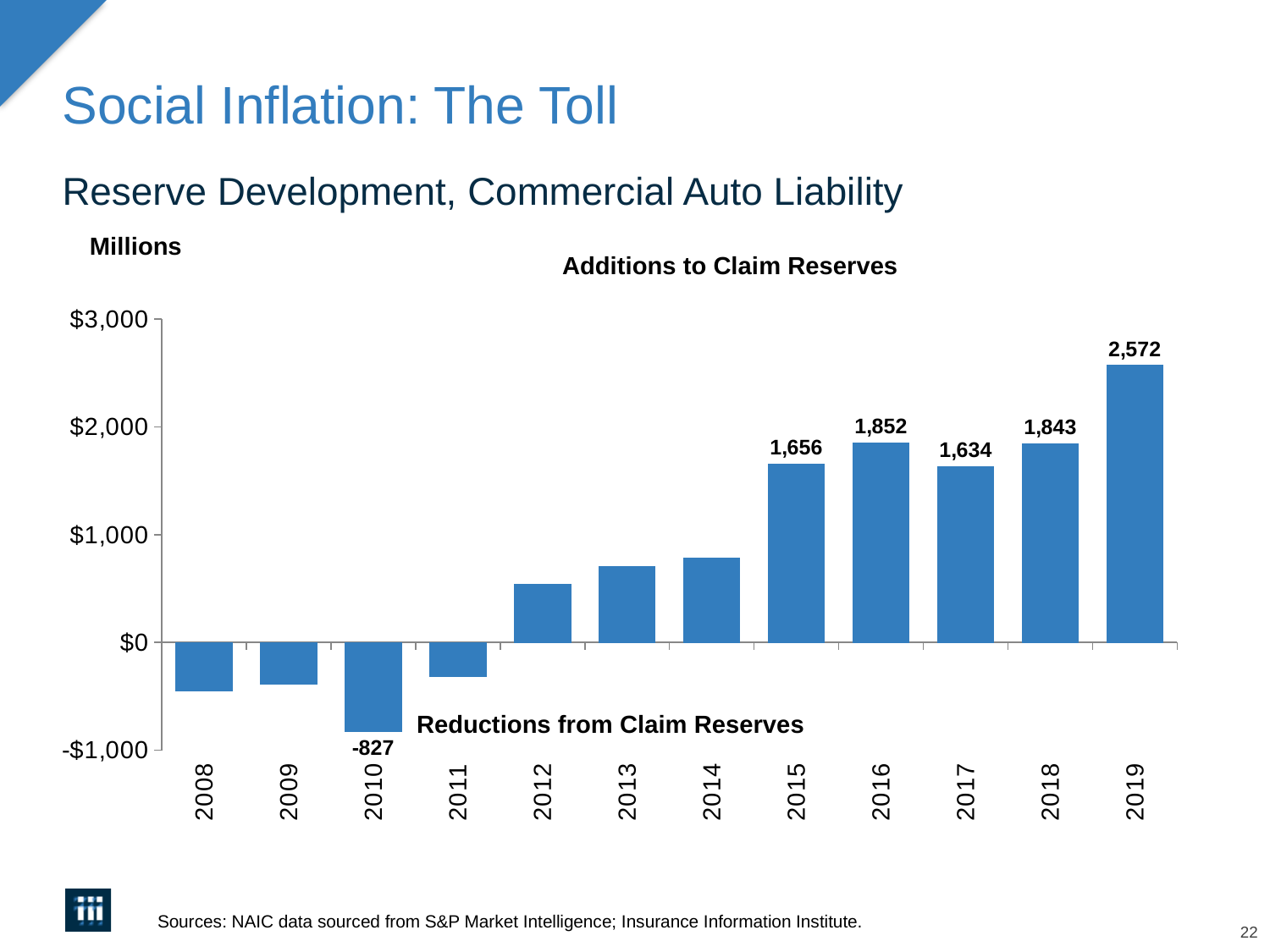
What is the value for 2016? 1,852 What is the difference between the values for 2019 and 2018? 729 Which is larger, the value for 2016 or the value for 2015? 2016 What is the value for 2010? -827 Which year has the highest value? 2019 What is the value for 2017? 1,634 Is the value for 2013 greater or less than $1,000? less What unit is indicated above the y axis? Millions Which year has the lowest value? 2010 How many years are shown on the x axis? 12 What kind of chart is shown? bar chart What is the value for 2019? 2,572